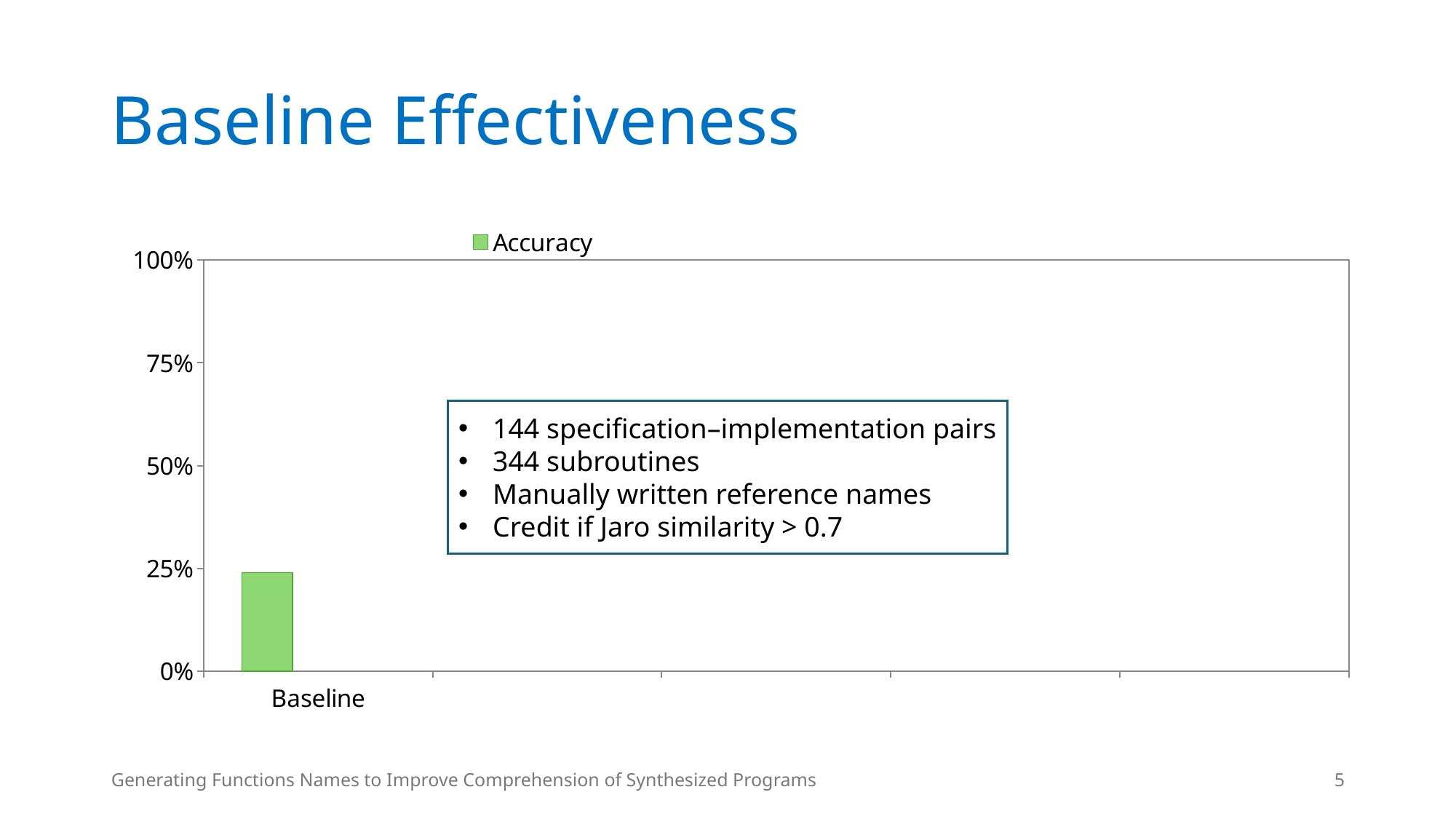
What is the name of the series shown in the chart legend? Accuracy How many series does the chart legend list? 1 Is the value for Baseline greater or less than 50%? less What kind of chart is shown on the slide? bar chart What is the label of the only category on the x axis? Baseline Is the value for Baseline greater or less than 75%? less How many bars are plotted in the chart? 1